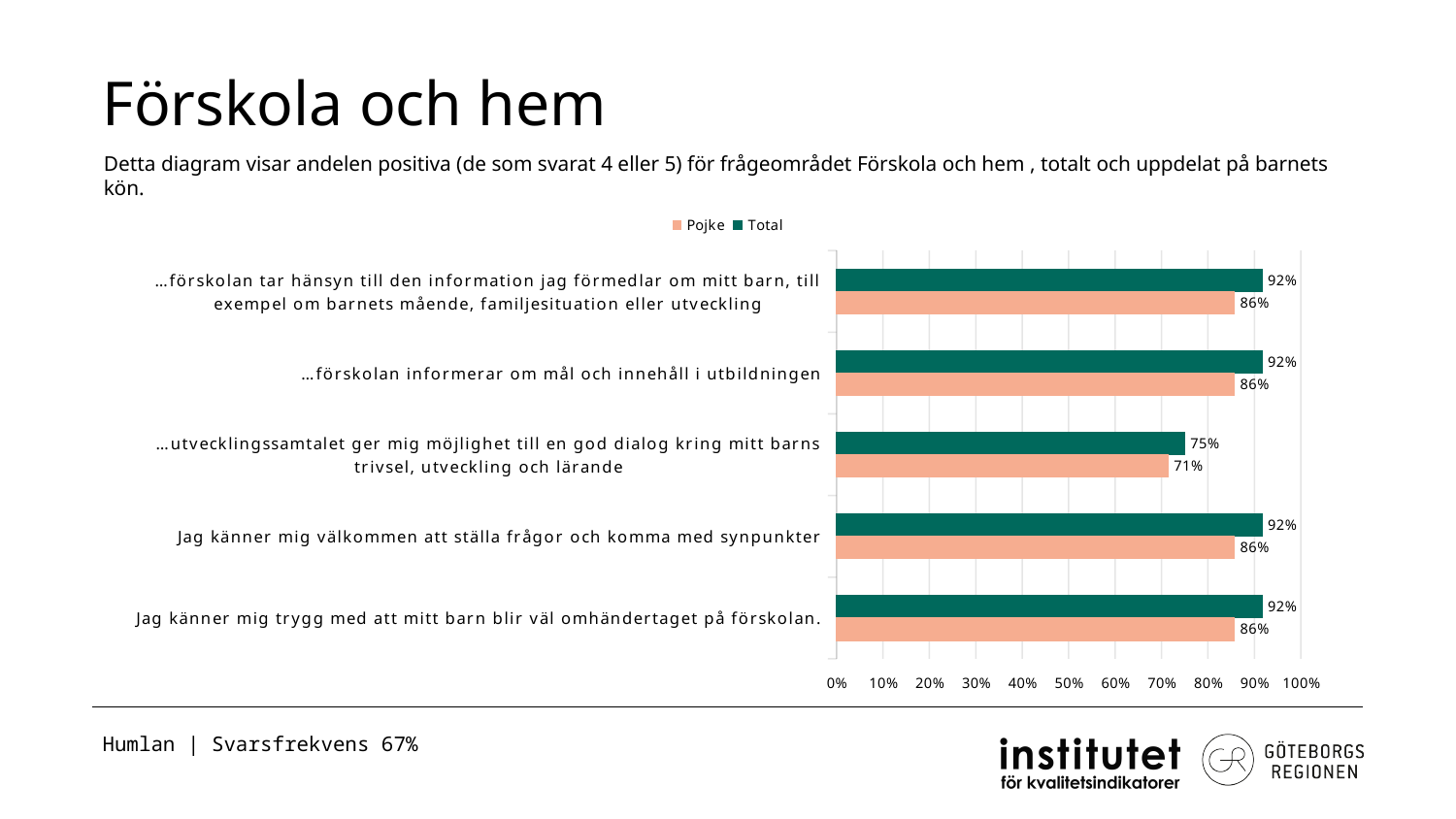
What kind of chart is shown on the slide? bar chart What is the Total value for "Jag känner mig trygg med att mitt barn blir väl omhändertaget på förskolan."? 92% What is the difference between the Total and Pojke values for "…utvecklingssamtalet ger mig möjlighet till en god dialog kring mitt barns trivsel, utveckling och lärande"? 4% How many categories are shown in the chart? 5 Which category has the lowest Total value? …utvecklingssamtalet ger mig möjlighet till en god dialog kring mitt barns trivsel, utveckling och lärande For "…förskolan tar hänsyn till den information jag förmedlar om mitt barn, till exempel om barnets mående, familjesituation eller utveckling", which is larger, the Pojke value or the Total value? Total Is the Pojke value for "…utvecklingssamtalet ger mig möjlighet till en god dialog kring mitt barns trivsel, utveckling och lärande" greater or less than 80%? less What is the Pojke value for "…utvecklingssamtalet ger mig möjlighet till en god dialog kring mitt barns trivsel, utveckling och lärande"? 71% What is the Pojke value for "…förskolan informerar om mål och innehåll i utbildningen"? 86% What is the difference between the Total and Pojke values for "Jag känner mig välkommen att ställa frågor och komma med synpunkter"? 6% What is the Total value for "…utvecklingssamtalet ger mig möjlighet till en god dialog kring mitt barns trivsel, utveckling och lärande"? 75% How many series does the legend list? 2